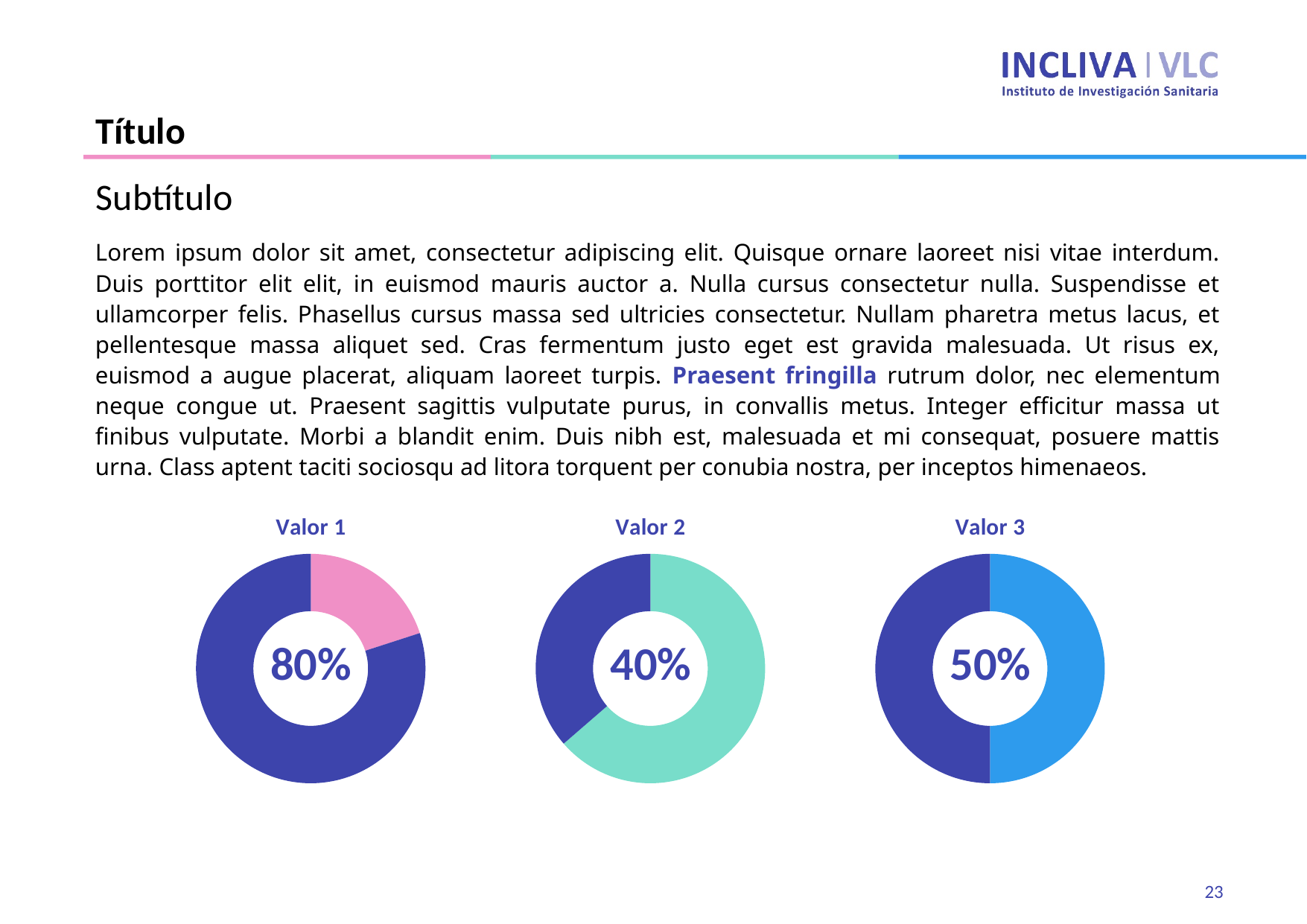
What is the difference between the percentage shown for Valor 3 and the percentage shown for Valor 2? 10% What value is shown in the centre of the Valor 1 donut chart? 80% Which of the three donut charts shows the lowest percentage? Valor 2 Which of the three donut charts shows the highest percentage? Valor 1 What value is shown in the centre of the Valor 2 donut chart? 40% Which is larger, the percentage shown for Valor 2 or the percentage shown for Valor 3? Valor 3 What is the difference between the percentage shown for Valor 1 and the percentage shown for Valor 2? 40% In the Valor 3 donut chart, what colour is the slice on the right half? Light blue What value is shown in the centre of the Valor 3 donut chart? 50% What kind of chart is used for Valor 1, Valor 2 and Valor 3? Donut chart In the Valor 1 donut chart, what colour is the smaller slice? Pink How many donut charts are shown on the slide? 3